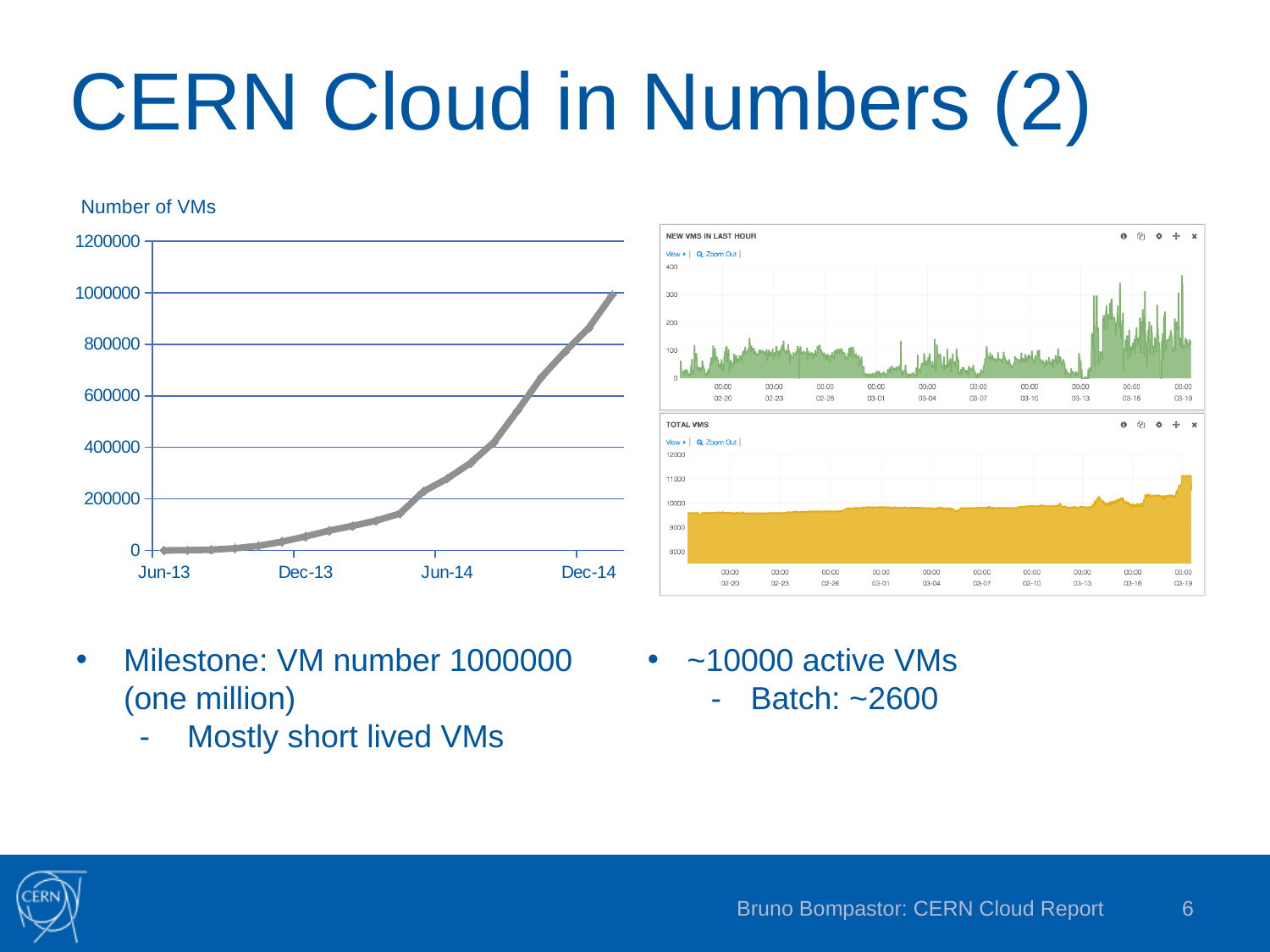
In the 'TOTAL VMS' chart on the right, is the value at the end of the period (03-19) greater or less than 10000? greater What is the highest value shown on the y axis of the 'Number of VMs' chart? 1200000 In the 'Number of VMs' chart, is the value at Dec-14 greater or less than 800000? greater What kind of chart is the 'Number of VMs' chart on the left of the slide? line chart How many date labels are shown on the x axis of the 'Number of VMs' chart? 4 What is the title of the upper chart on the right side of the slide? NEW VMS IN LAST HOUR In the 'Number of VMs' chart, which labelled date on the x axis has the lowest value? Jun-13 In the 'Number of VMs' chart, is the value at Jun-14 greater or less than 200000? greater In the 'Number of VMs' chart, which is larger, the value at Jun-14 or the value at Dec-13? Jun-14 In the 'Number of VMs' chart, which labelled date on the x axis has the highest value? Dec-14 In the 'Number of VMs' chart, do the values rise or fall from Jun-13 to Dec-14? rise